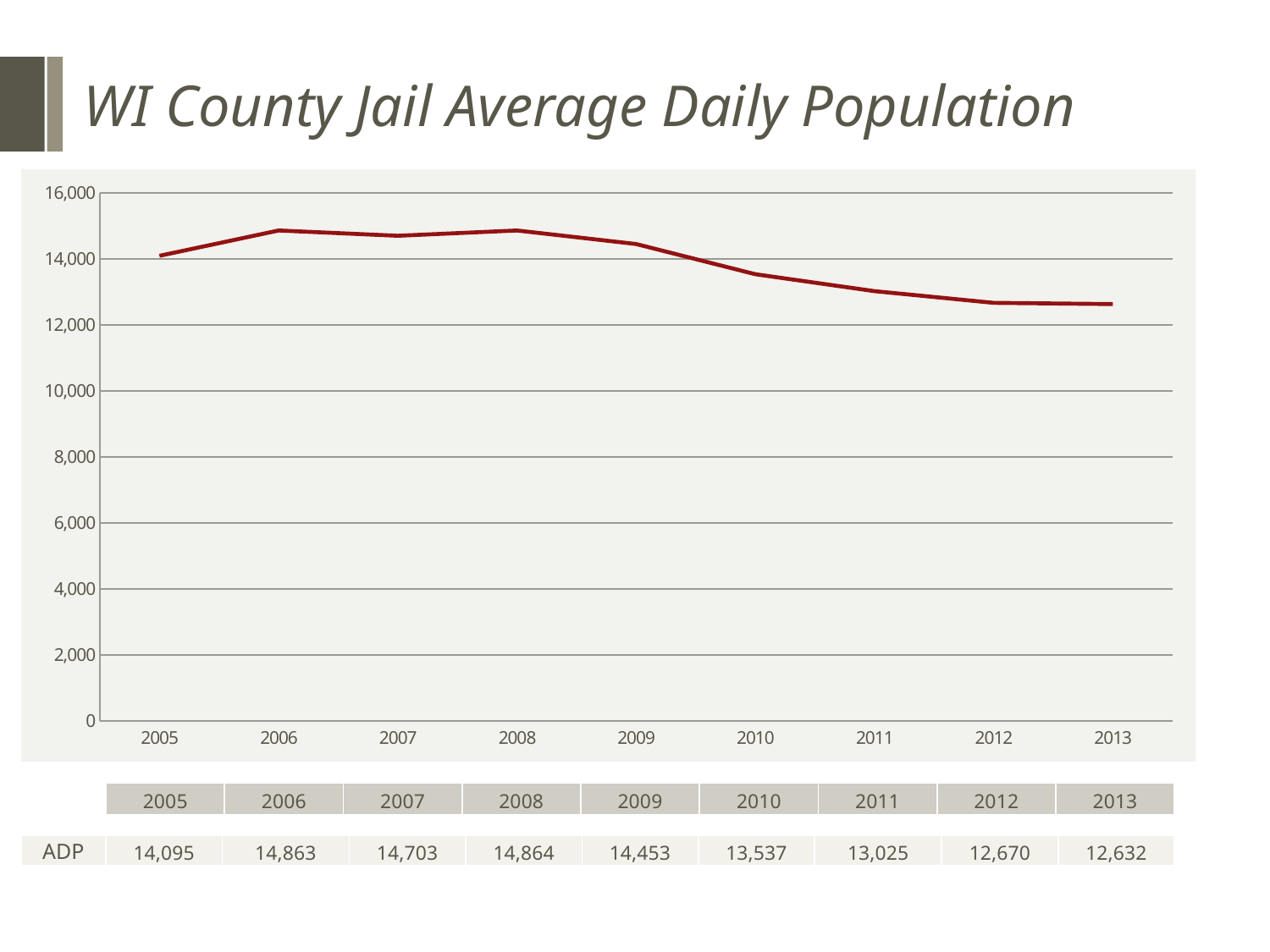
What is the difference between the ADP values for 2005 and 2013? 1,463 Which year has the larger ADP value, 2005 or 2009? 2009 What is the ADP value for 2013? 12,632 Is the ADP value for 2011 greater or less than 14,000? less What kind of chart is shown on the slide? line chart How many years are plotted on the x axis? 9 What is the ADP value for 2005? 14,095 What is the title of the slide? WI County Jail Average Daily Population What is the difference between the ADP values for 2009 and 2010? 916 What is the ADP value for 2010? 13,537 What is the ADP value for 2008? 14,864 Does the ADP value rise or fall from 2008 to 2013? fall